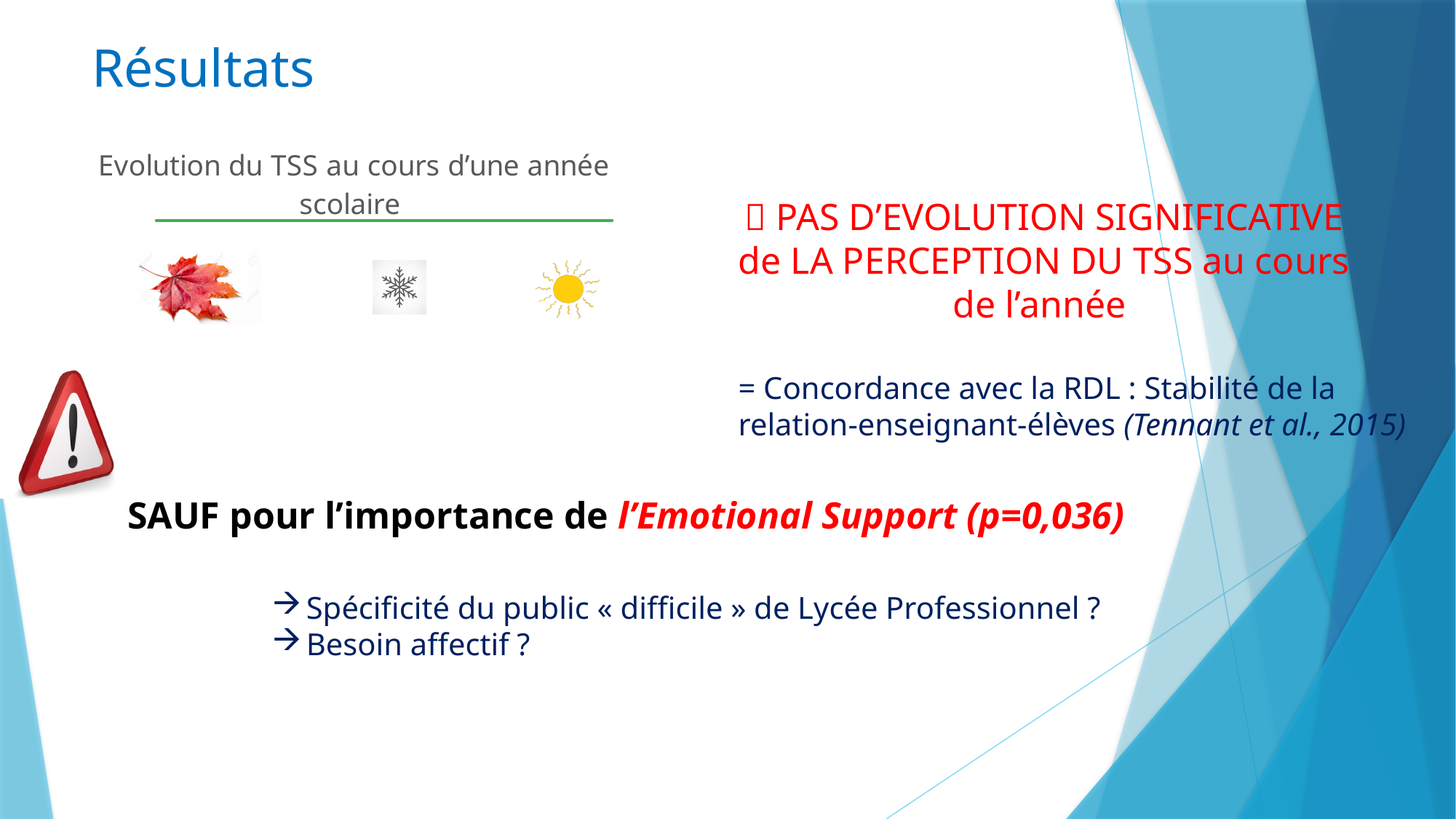
How many season icons (time points) are shown along the x axis of the chart "Evolution du TSS au cours d'une année scolaire"? 3 What is the title of the chart on the left of the slide? Evolution du TSS au cours d'une année scolaire How many lines (series) are plotted in the chart "Evolution du TSS au cours d'une année scolaire"? 1 What kind of chart is shown under the title "Evolution du TSS au cours d'une année scolaire"? line chart In the chart "Evolution du TSS au cours d'une année scolaire", does the green line rise, fall or stay flat across the school year? stays flat What colour is the line plotted in the chart "Evolution du TSS au cours d'une année scolaire"? green